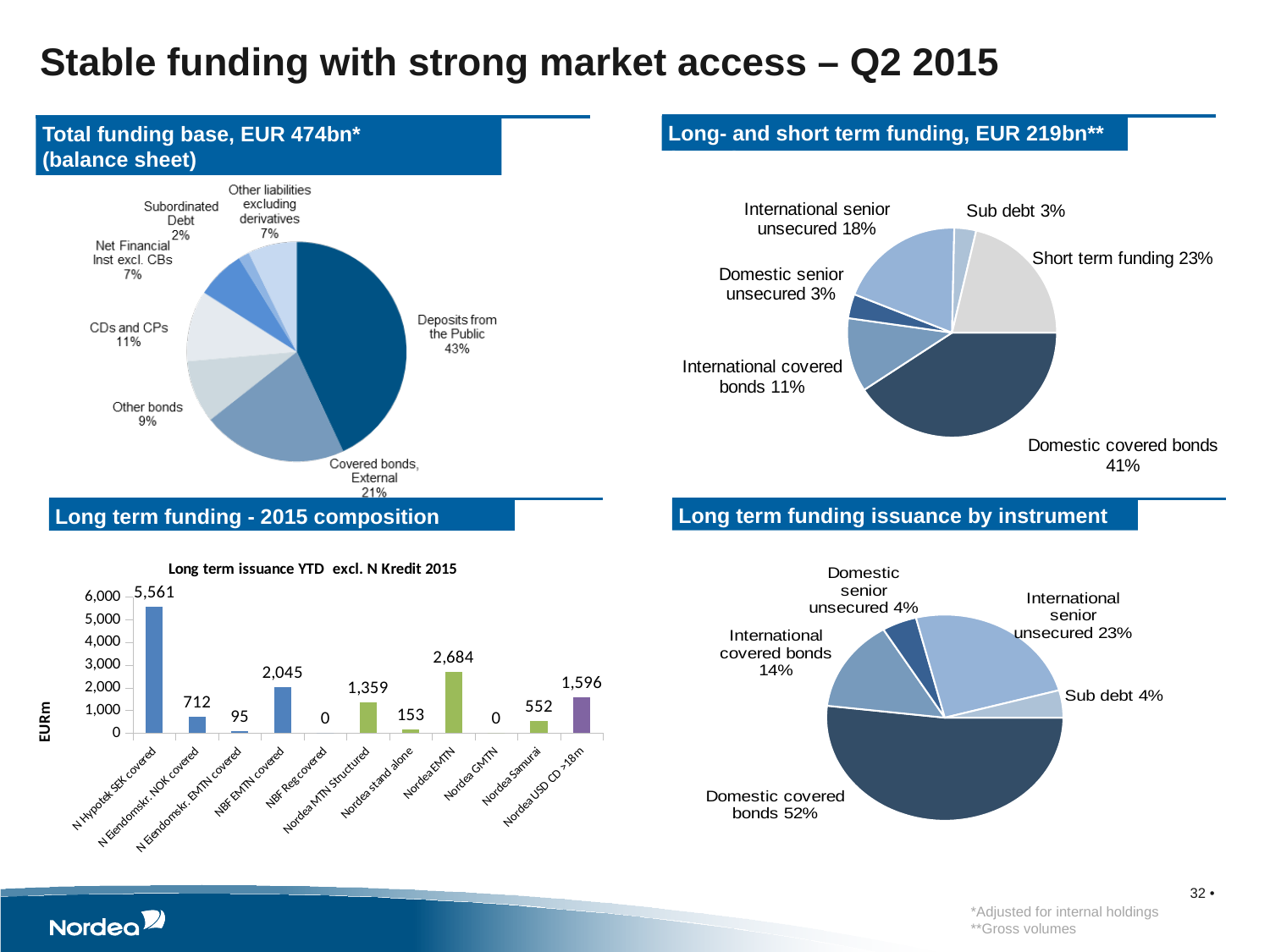
In the 'Long term funding issuance by instrument' pie chart, what is the difference in percentage points between International senior unsecured and Sub debt? 19 percentage points In the 'Total funding base, EUR 474bn' pie chart, which category has the smallest share? Subordinated Debt In the 'Total funding base, EUR 474bn' pie chart, what share is Deposits from the Public? 43% In the 'Long- and short term funding, EUR 219bn' pie chart, which category has the largest share? Domestic covered bonds In the 'Long term issuance YTD excl. N Kredit 2015' bar chart, what is the value for Nordea EMTN? 2,684 What type of chart is 'Long term issuance YTD excl. N Kredit 2015'? Bar chart In the 'Long- and short term funding, EUR 219bn' pie chart, what share is Short term funding? 23% In the 'Long term issuance YTD excl. N Kredit 2015' bar chart, which is larger: NBF EMTN covered or Nordea USD CD >18m? NBF EMTN covered In the 'Long- and short term funding, EUR 219bn' pie chart, what is the difference in percentage points between International senior unsecured and International covered bonds? 7 percentage points In the 'Long term issuance YTD excl. N Kredit 2015' bar chart, what is the value for N Hypotek SEK covered? 5,561 In the 'Long term funding issuance by instrument' pie chart, what share is Domestic covered bonds? 52% In the 'Long term issuance YTD excl. N Kredit 2015' bar chart, how many categories are shown on the x axis? 11